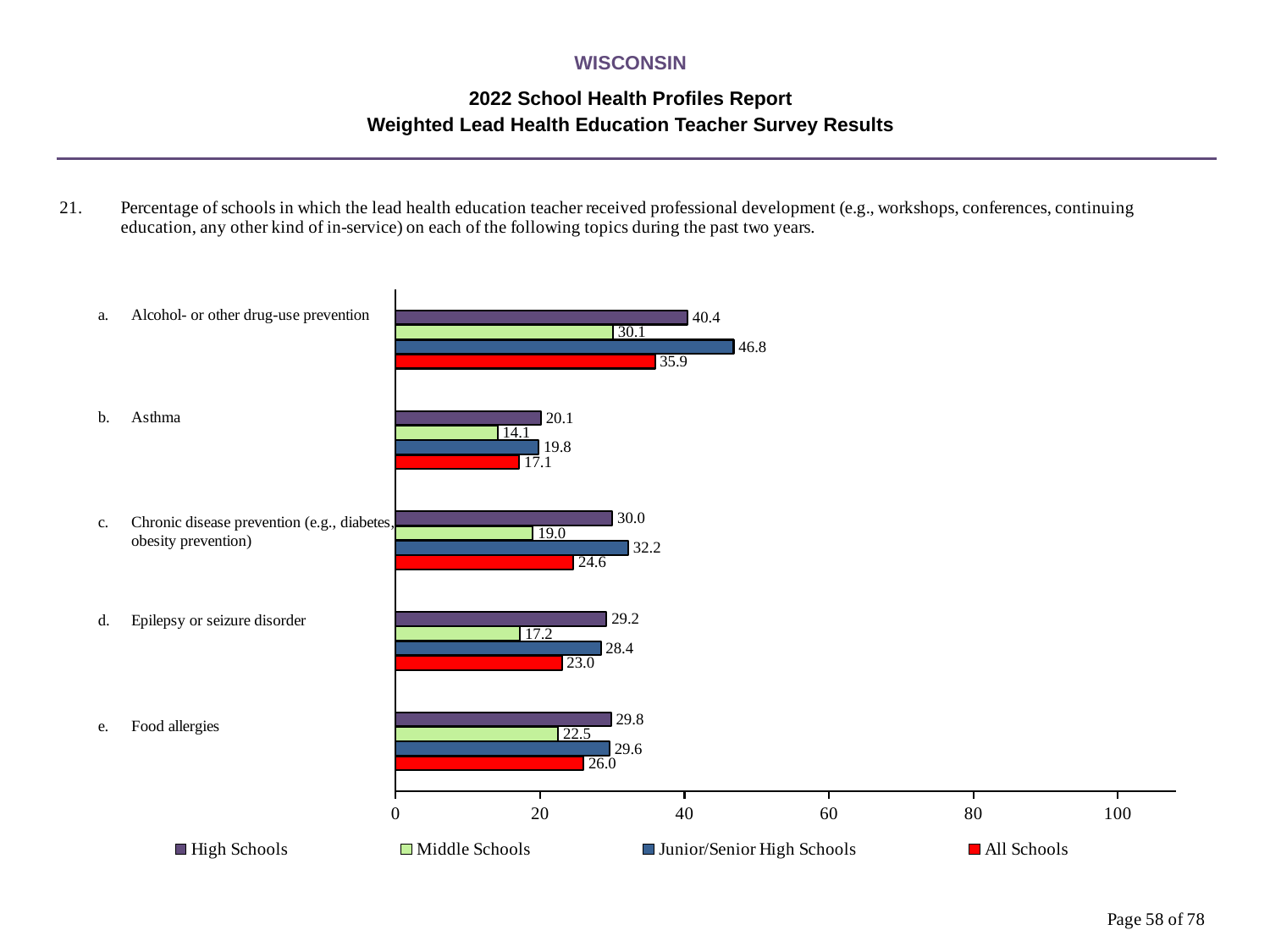
Which topic has the lowest value for All Schools? Asthma Which is larger for Chronic disease prevention: the High Schools value or the Junior/Senior High Schools value? Junior/Senior High Schools What is the value for Junior/Senior High Schools for Alcohol- or other drug-use prevention? 46.8 What is the value for Middle Schools for Asthma? 14.1 How many series does the legend list? 4 What kind of chart is shown on the slide? bar chart Which series is shown in red in the legend? All Schools What is the value for All Schools for Food allergies? 26.0 Which topic has the highest value for High Schools? Alcohol- or other drug-use prevention Is the value for All Schools for Alcohol- or other drug-use prevention greater or less than 40? less What is the difference between the High Schools and Middle Schools values for Epilepsy or seizure disorder? 12.0 How many topics are shown on the chart? 5